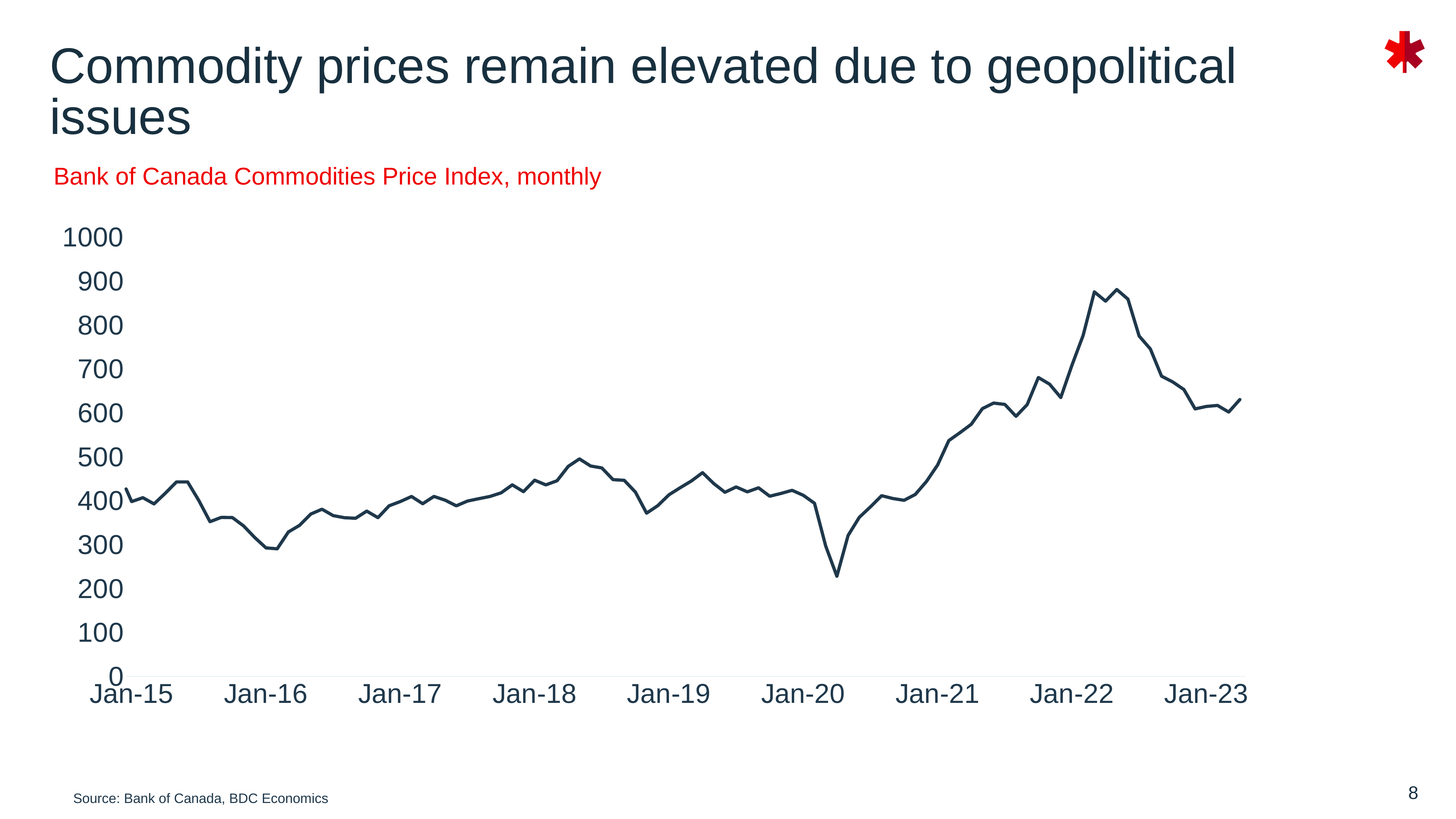
Which is larger, the value at Jan-22 or the value at Jan-18? Jan-22 Is the highest point on the line greater or less than 800? greater Is the value at Jan-23 greater or less than 700? less Between which two x-axis labels does the line reach its highest value? Jan-22 and Jan-23 What kind of chart is shown on the slide? line chart Is the lowest point on the line greater or less than 300? less Does the line rise or fall from its peak in 2022 to Jan-23? fall Does the line rise or fall between Jan-21 and Jan-22? rise What is the title of the chart? Bank of Canada Commodities Price Index, monthly